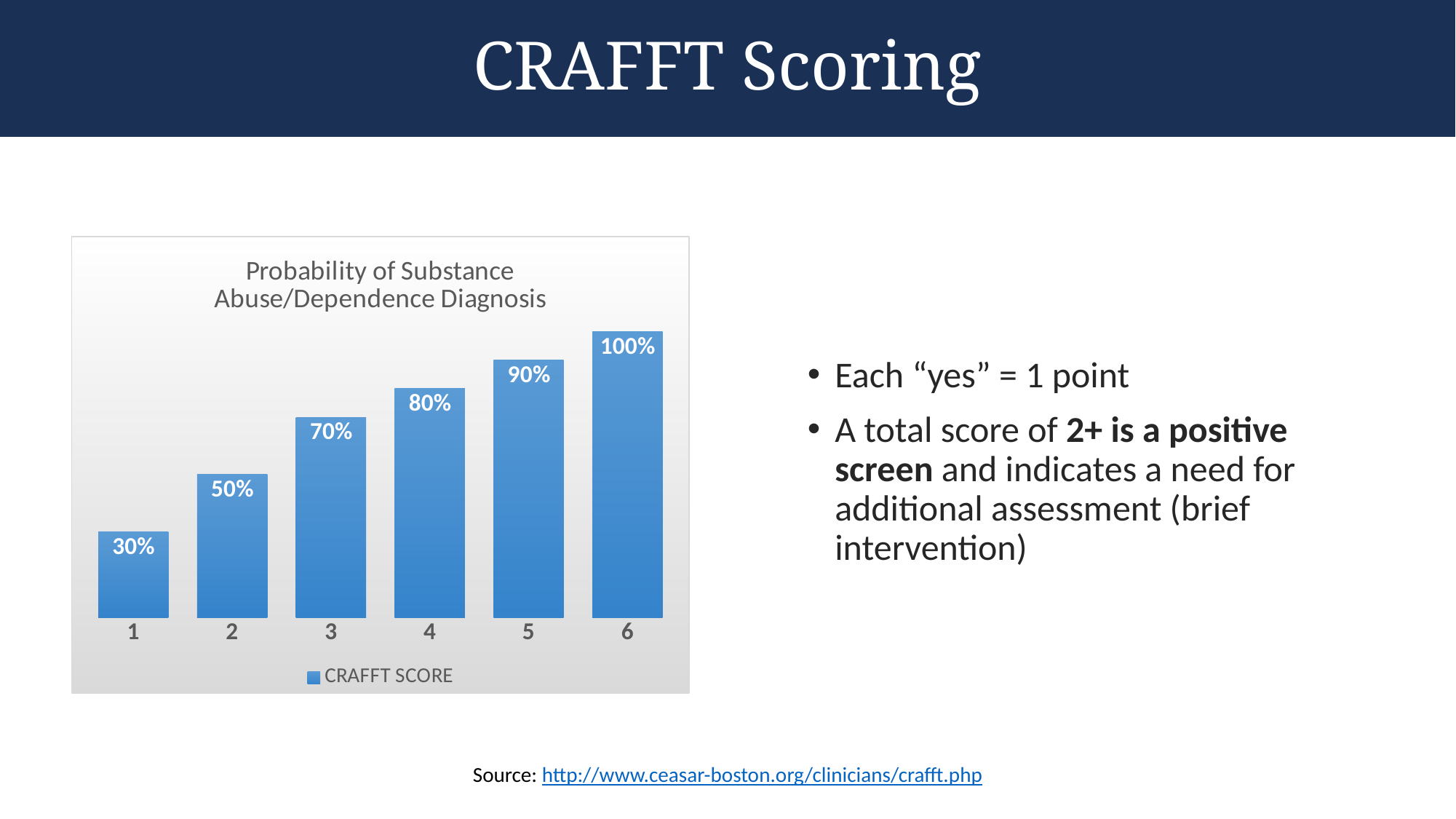
What is the difference between the values for CRAFFT scores 3 and 2? 20% What is the value shown for a CRAFFT score of 4? 80% Which CRAFFT score has the highest probability of diagnosis? 6 What is the difference between the values for CRAFFT scores 6 and 1? 70% What kind of chart is shown on the slide? Bar chart What is the probability of substance abuse/dependence diagnosis for a CRAFFT score of 1? 30% Which CRAFFT score has the lowest probability of diagnosis? 1 What is the value shown for a CRAFFT score of 6? 100% How many series does the legend list? 1 Do the values rise or fall as the CRAFFT score increases from 1 to 6? Rise How many CRAFFT score categories are plotted in the chart? 6 Which has a higher value, a CRAFFT score of 2 or a CRAFFT score of 5? 5